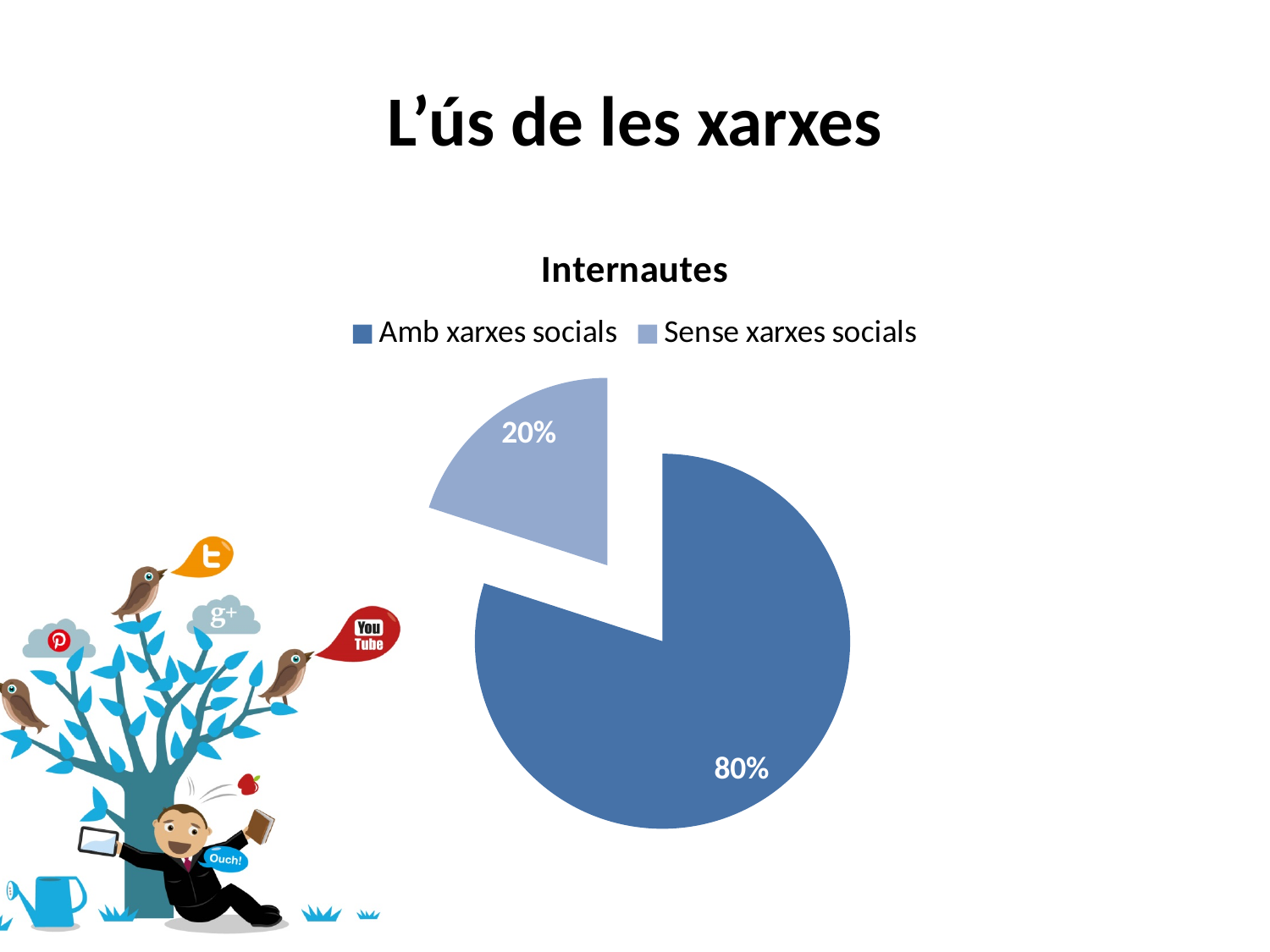
Which slice is the smallest? Sense xarxes socials What type of chart is shown on the slide? pie chart How many entries does the legend list? 2 What percentage of the pie is 'Amb xarxes socials'? 80% Which legend entry is shown in the lighter blue colour? Sense xarxes socials What is the title of the chart? Internautes What is the difference in percentage points between 'Amb xarxes socials' and 'Sense xarxes socials'? 60 How many slices does the pie chart have? 2 What share of the pie does 'Sense xarxes socials' represent? 20% Which is larger, 'Amb xarxes socials' or 'Sense xarxes socials'? Amb xarxes socials Which slice is the largest? Amb xarxes socials What percentage of the pie is 'Sense xarxes socials'? 20%